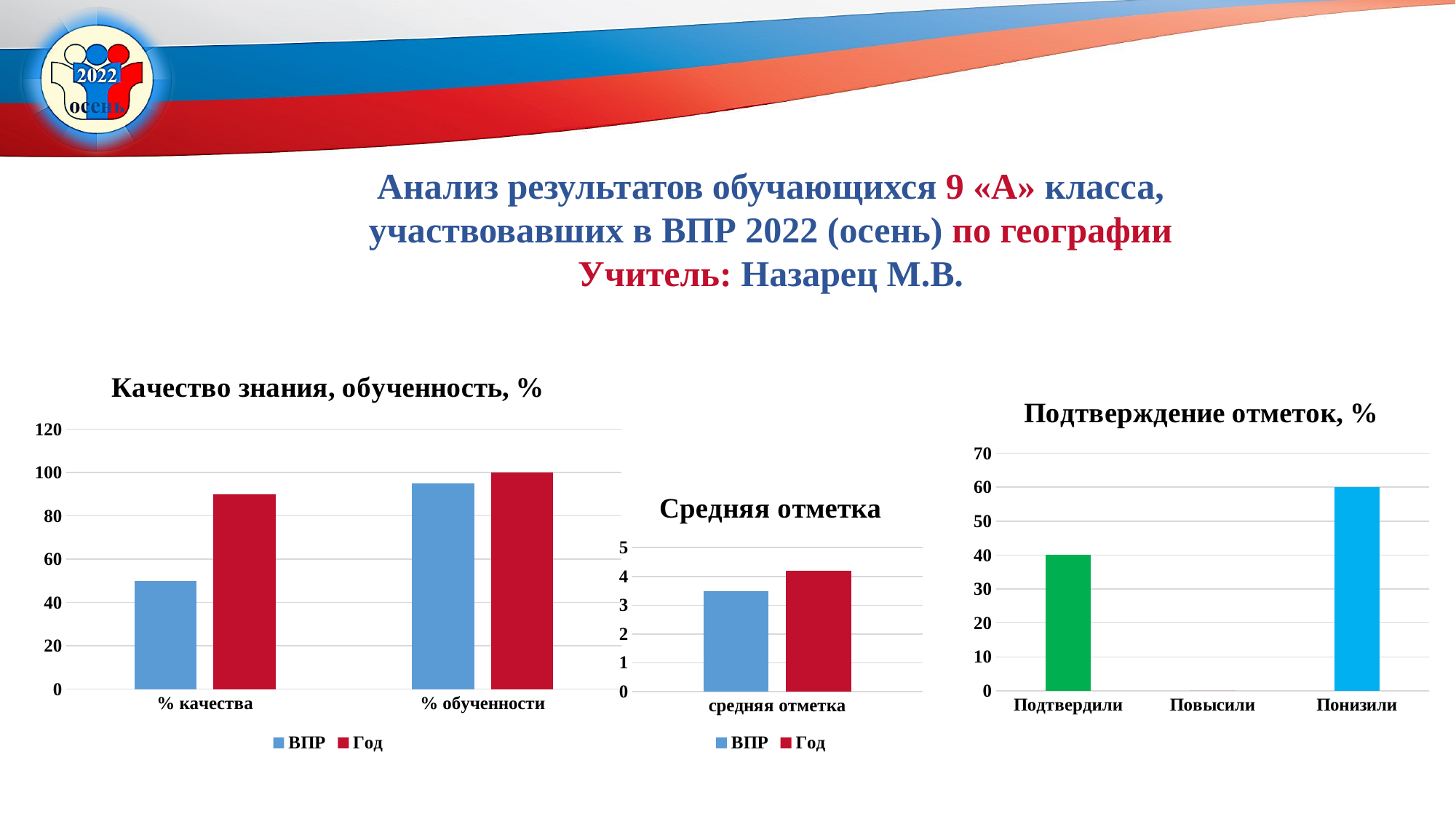
How many series does the legend of the "Качество знания, обученность, %" chart list? 2 In the "Подтверждение отметок, %" chart, what is the difference between Понизили and Подтвердили? 20 What kind of chart is the "Качество знания, обученность, %" chart? bar chart In the "Средняя отметка" chart, which series has the larger value: ВПР or Год? Год In the "Подтверждение отметок, %" chart, which category has the lowest value? Повысили How many categories are shown in the "Подтверждение отметок, %" chart? 3 In the "Качество знания, обученность, %" chart, which is larger for % качества: ВПР or Год? Год In the "Подтверждение отметок, %" chart, what is the value for Подтвердили? 40 In the "Качество знания, обученность, %" chart, what is the value of Год for % обученности? 100 In the "Подтверждение отметок, %" chart, what is the value for Понизили? 60 In the "Средняя отметка" chart, is the ВПР value greater or less than 4? less In the "Качество знания, обученность, %" chart, is the ВПР value for % качества greater or less than 60? less